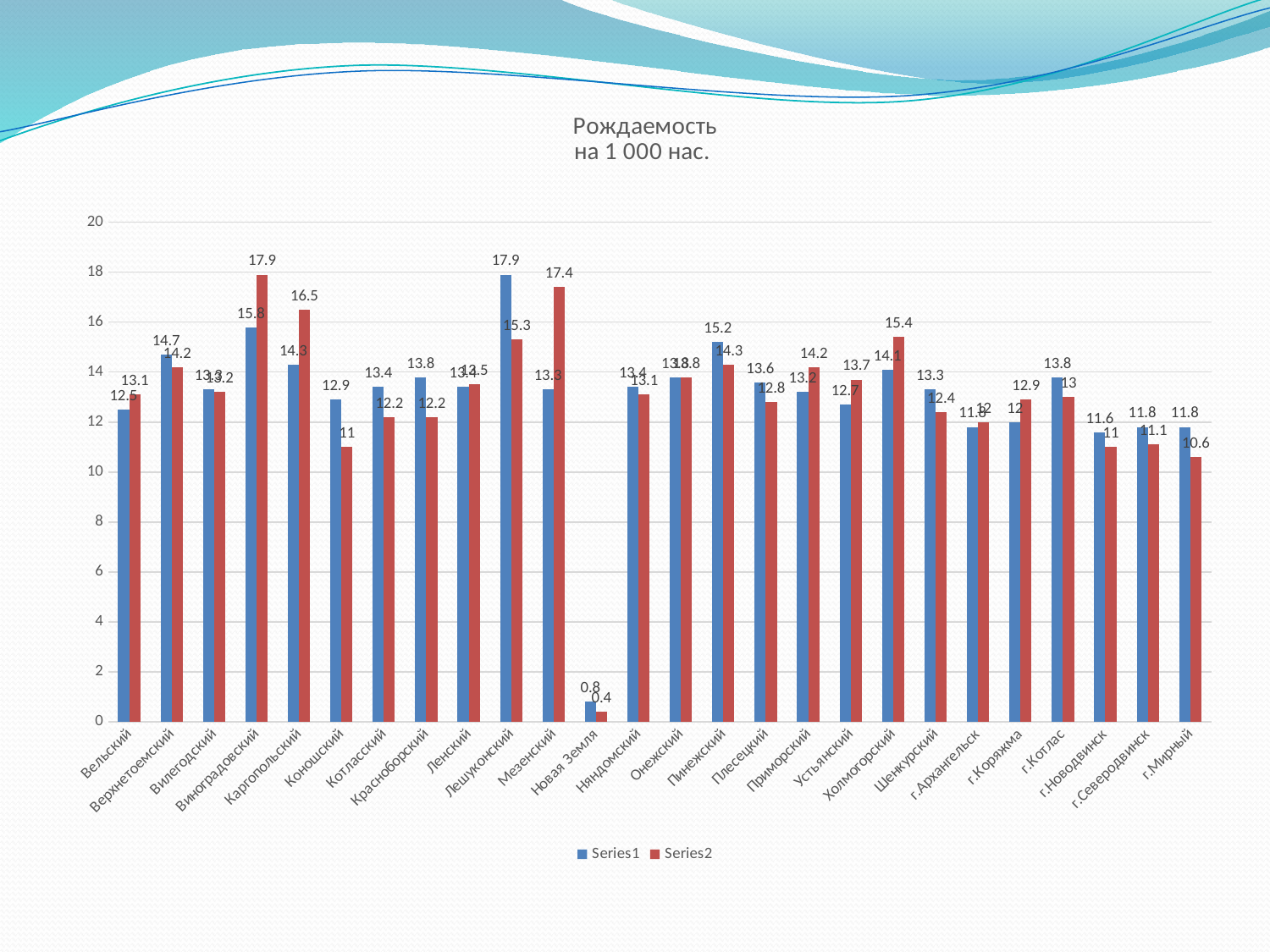
What is the Series2 value for Виноградовский? 17.9 Which category has the lowest Series1 value? Новая Земля Which category has the highest Series2 value? Виноградовский What type of chart is shown on the slide? bar chart How many series does the legend list? 2 What is the title of the chart? Рождаемость на 1 000 нас. How many categories are shown on the x axis? 26 Which is larger for Коношский, the Series1 value or the Series2 value? Series1 What is the Series1 value for Лешуконский? 17.9 What is the difference between the Series2 and Series1 values for Каргопольский? 2.2 What is the Series1 value for Новая Земля? 0.8 What is the Series2 value for Мезенский? 17.4